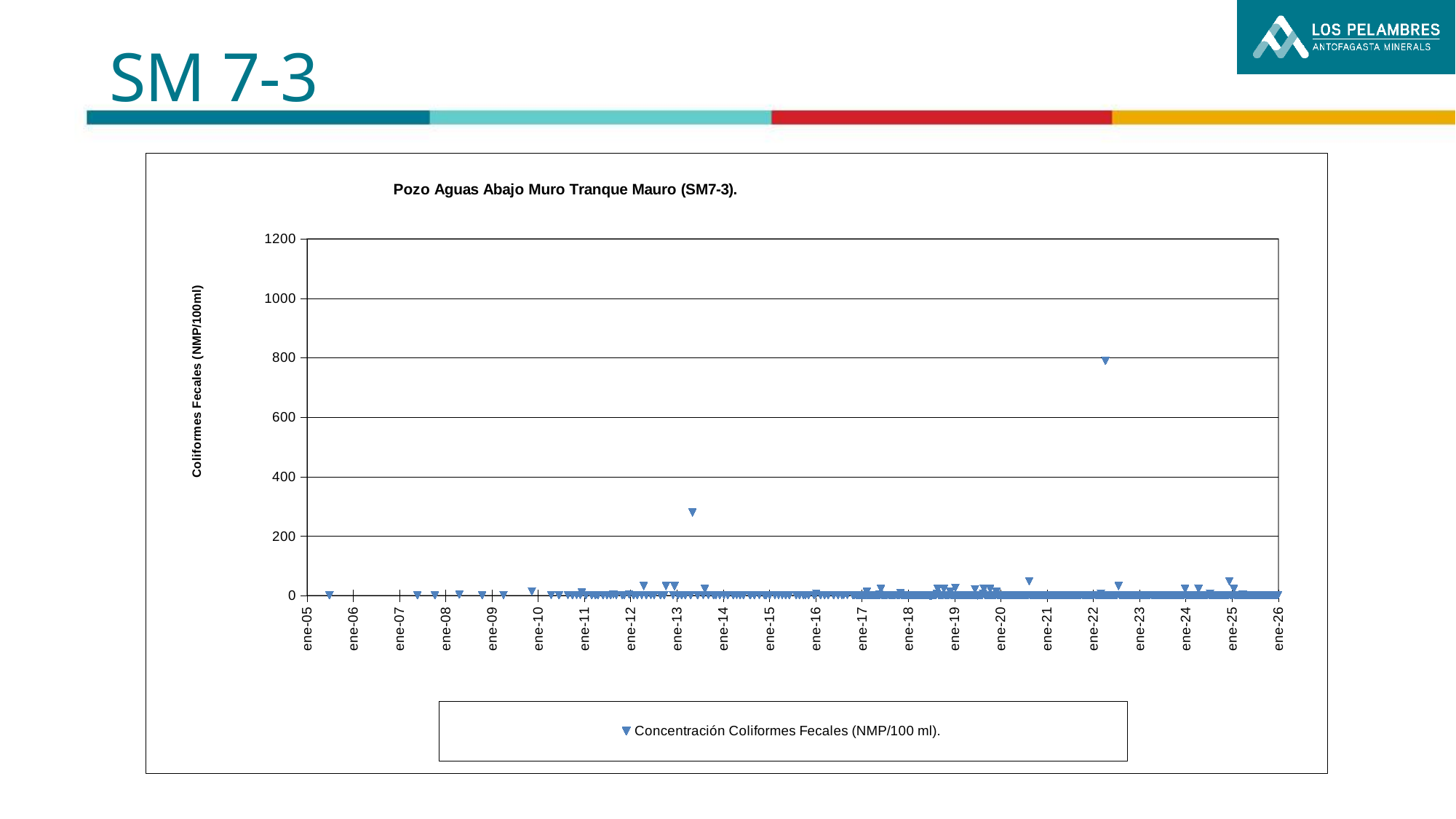
What is the title of the chart? Pozo Aguas Abajo Muro Tranque Mauro (SM7-3). What is the maximum value shown on the y axis? 1200 Which is larger: the peak value near ene-22 or the peak value between ene-13 and ene-14? the peak near ene-22 Is the isolated high point between ene-13 and ene-14 greater or less than 200? greater In which year does the highest plotted value occur? 2022 How many series does the legend list? 1 What is the name of the series shown in the legend? Concentración Coliformes Fecales (NMP/100 ml). Is the highest plotted value on the chart greater or less than 1000? less Is the isolated high point between ene-13 and ene-14 greater or less than 400? less What kind of chart is shown on the slide? scatter chart How many year labels are shown on the x axis? 22